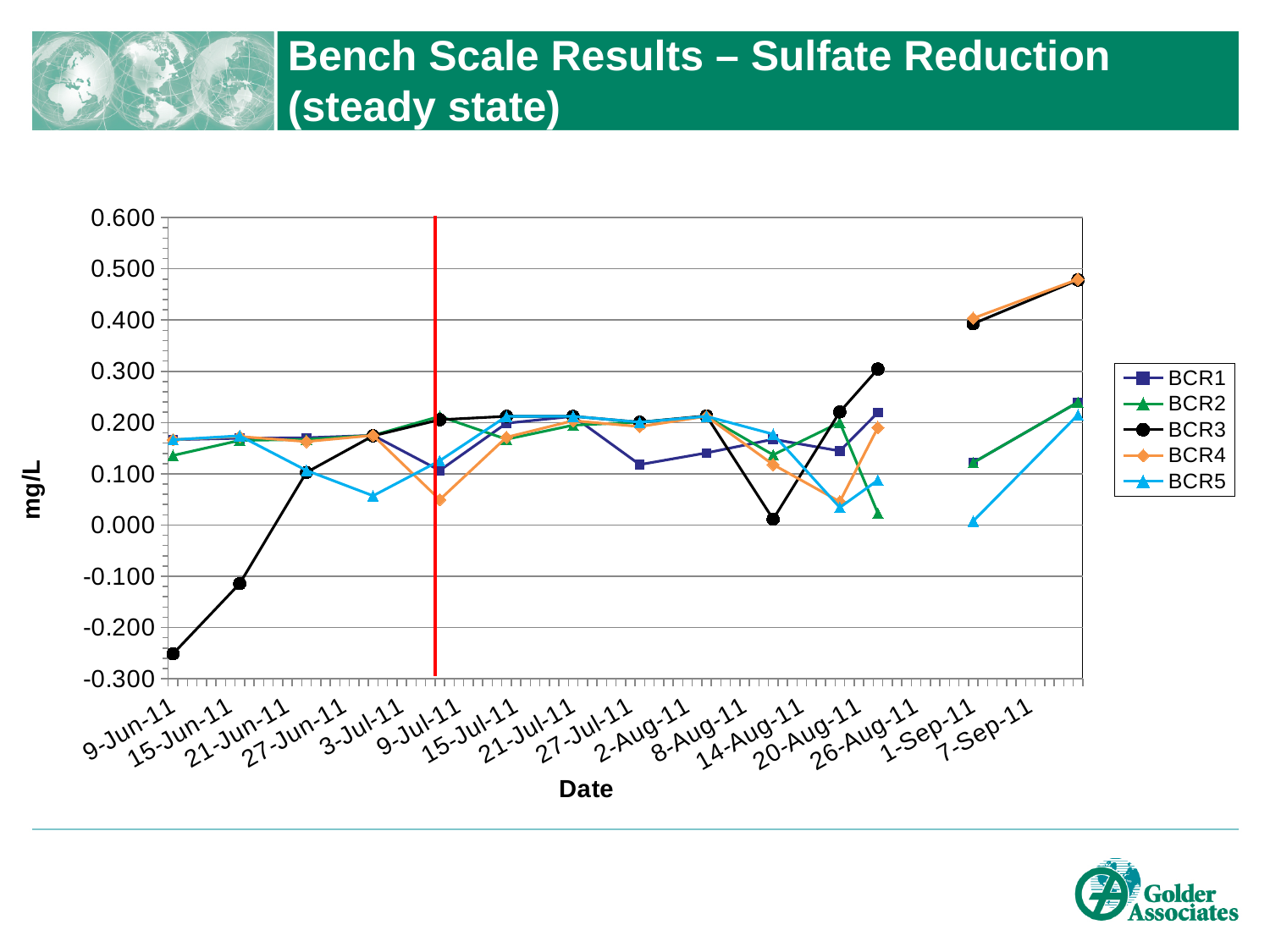
Does the BCR3 series rise or fall between 9-Jun-11 and 9-Jul-11? Rise Is the value for BCR4 on 7-Sep-11 greater or less than 0.400? greater Is the value for BCR3 on 9-Jun-11 greater or less than -0.200? less What kind of chart is shown on the slide? Line chart Is the value for BCR3 on 26-Aug-11 greater or less than 0.200? greater Which series has the lowest value anywhere on the chart? BCR3 What is the label on the y axis? mg/L On 9-Jun-11, which is larger, the value for BCR1 or the value for BCR3? BCR1 How many series does the legend list? 5 On 14-Aug-11, which is larger, the value for BCR3 or the value for BCR5? BCR5 How many date labels are shown on the x axis? 16